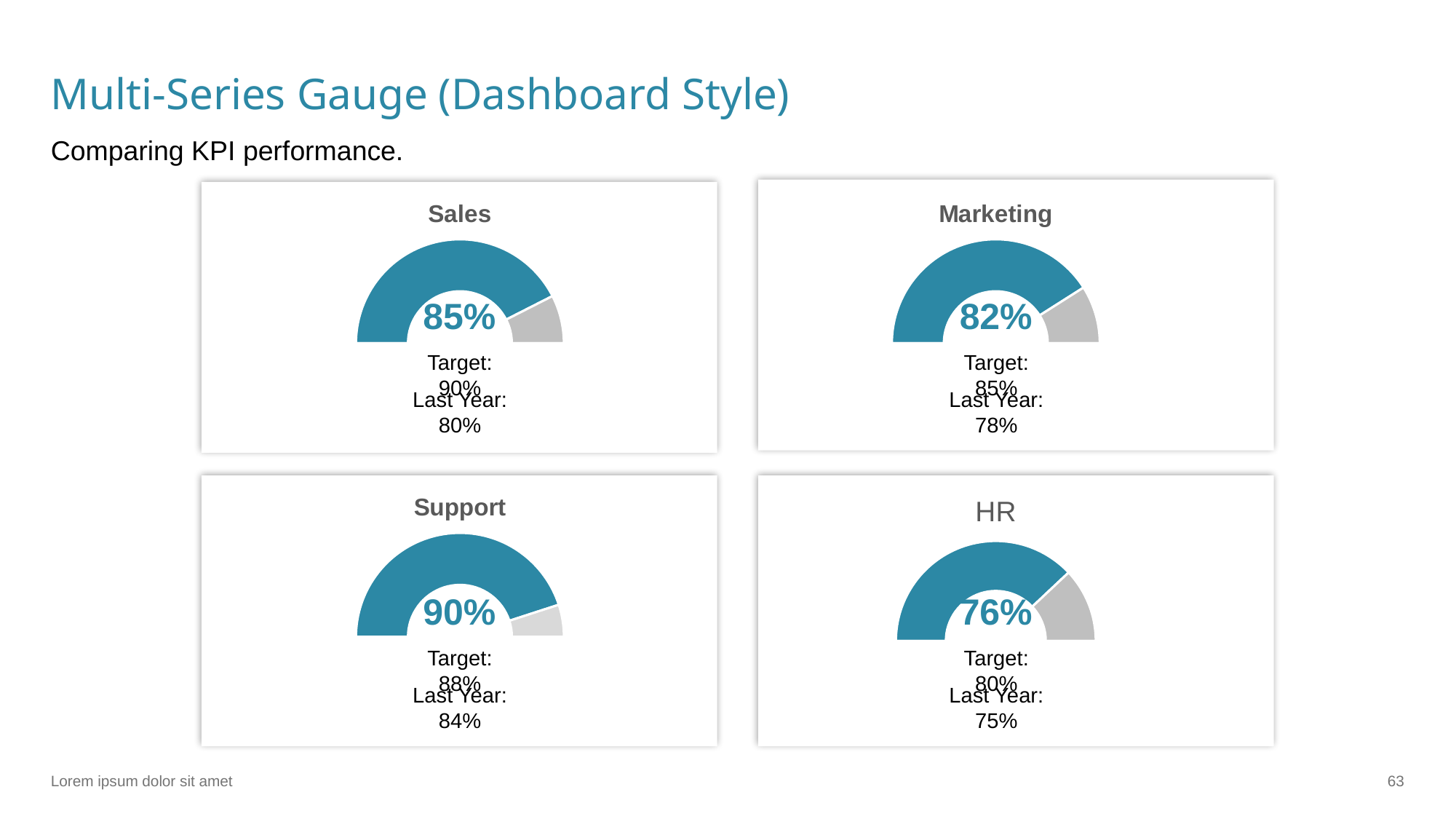
On the HR gauge, what is the Last Year value printed below the gauge? 75% On the Sales gauge, what is the target value printed below the gauge? 90% Which is larger: the Support gauge value or the HR gauge value? Support On the HR gauge, what value is shown? 76% Across the four gauges on the slide, which department shows the lowest value? HR What is the difference between the Sales gauge value and the Marketing gauge value? 3% On the Support gauge, what value is shown? 90% How many gauge charts are shown on the slide? 4 Across the four gauges on the slide, which department shows the highest value? Support What kind of chart is used for each department on the slide? Gauge chart On the Marketing gauge, what value is shown? 82% On the Sales gauge, what value is shown? 85%